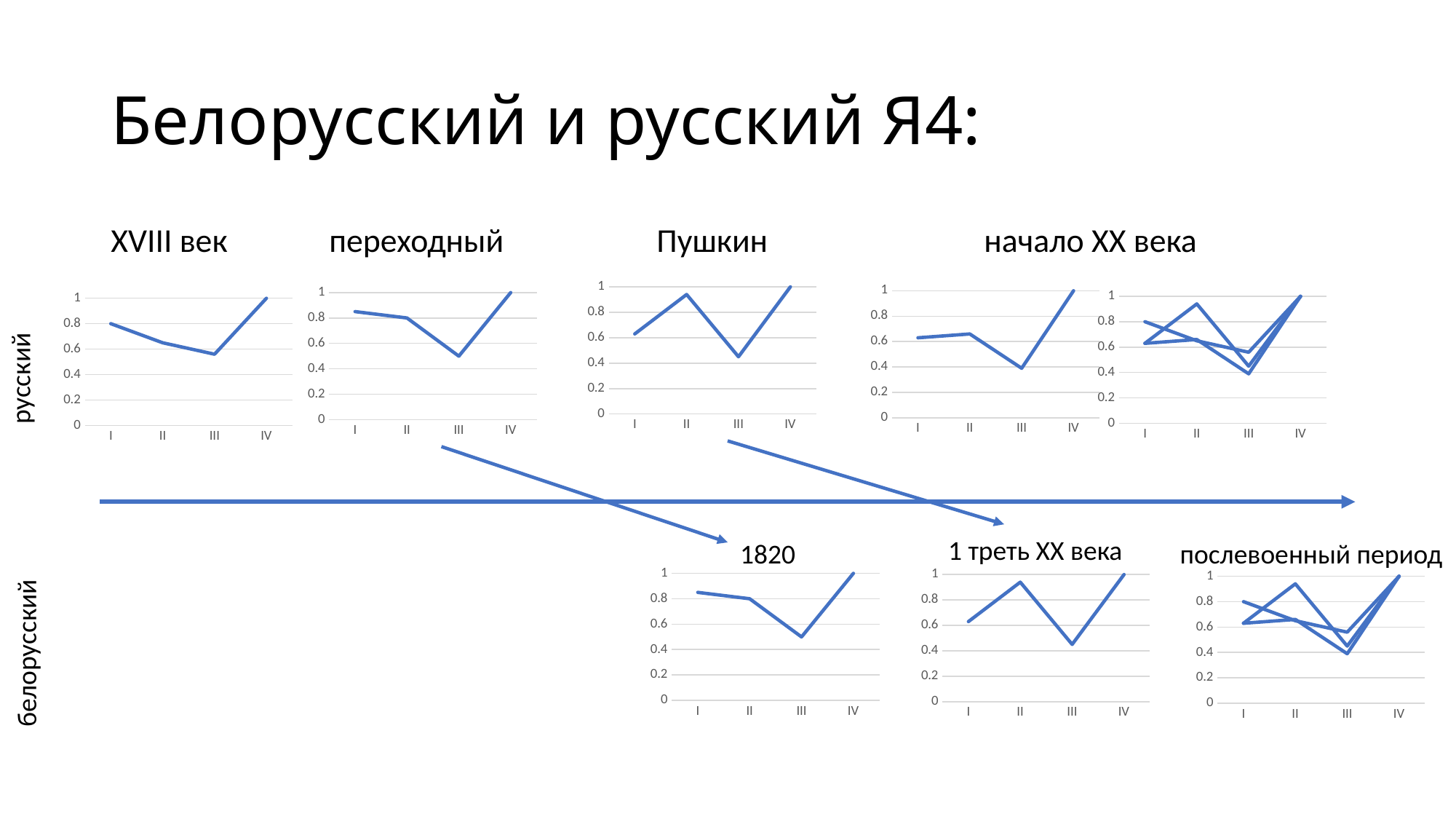
In the 'XVIII век' chart, what is the value at category IV? 1 What kind of chart is the 'XVIII век' chart? line chart In the 'Пушкин' chart, is the value for II greater or less than 0.8? greater In the '1 треть XX века' chart, is the value for I greater or less than 0.8? less In the '1820' chart, do the values rise or fall from II to III? fall How many categories are on the x axis of the 'XVIII век' chart? 4 How many lines are plotted in the 'послевоенный период' chart? 3 In the 'Пушкин' chart, which is larger, the value for II or the value for III? II In the 'Пушкин' chart, which category has the lowest value? III In the 'XVIII век' chart, is the value for II greater or less than 0.8? less In the 'XVIII век' chart, which category has the lowest value? III